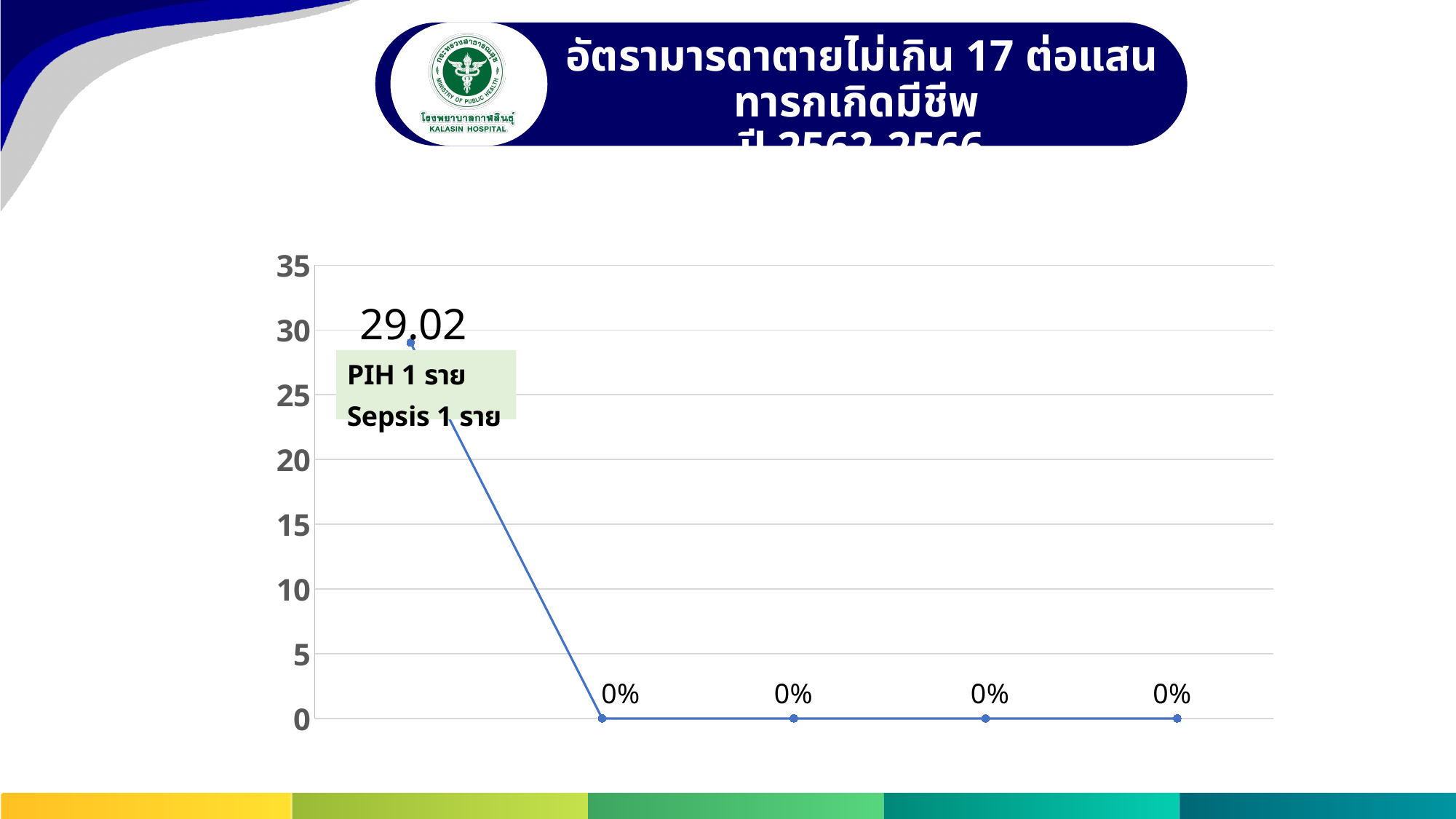
What is the data label on the last (rightmost) point of the line? 0% Is the value of the first point greater or less than 30? less How many of the plotted points are labelled 0%? 4 What is the highest value shown on the vertical axis? 35 Is the value of the first point greater or less than 25? greater What does the annotation box near the first point say? PIH 1 ราย Sepsis 1 ราย What kind of chart is shown on the slide? line chart How many data points are plotted on the line? 5 What is the data label on the first (leftmost) point of the line? 29.02 Do the values rise or fall from the first point to the second point? fall Which point on the line has the highest value? the first (leftmost) point